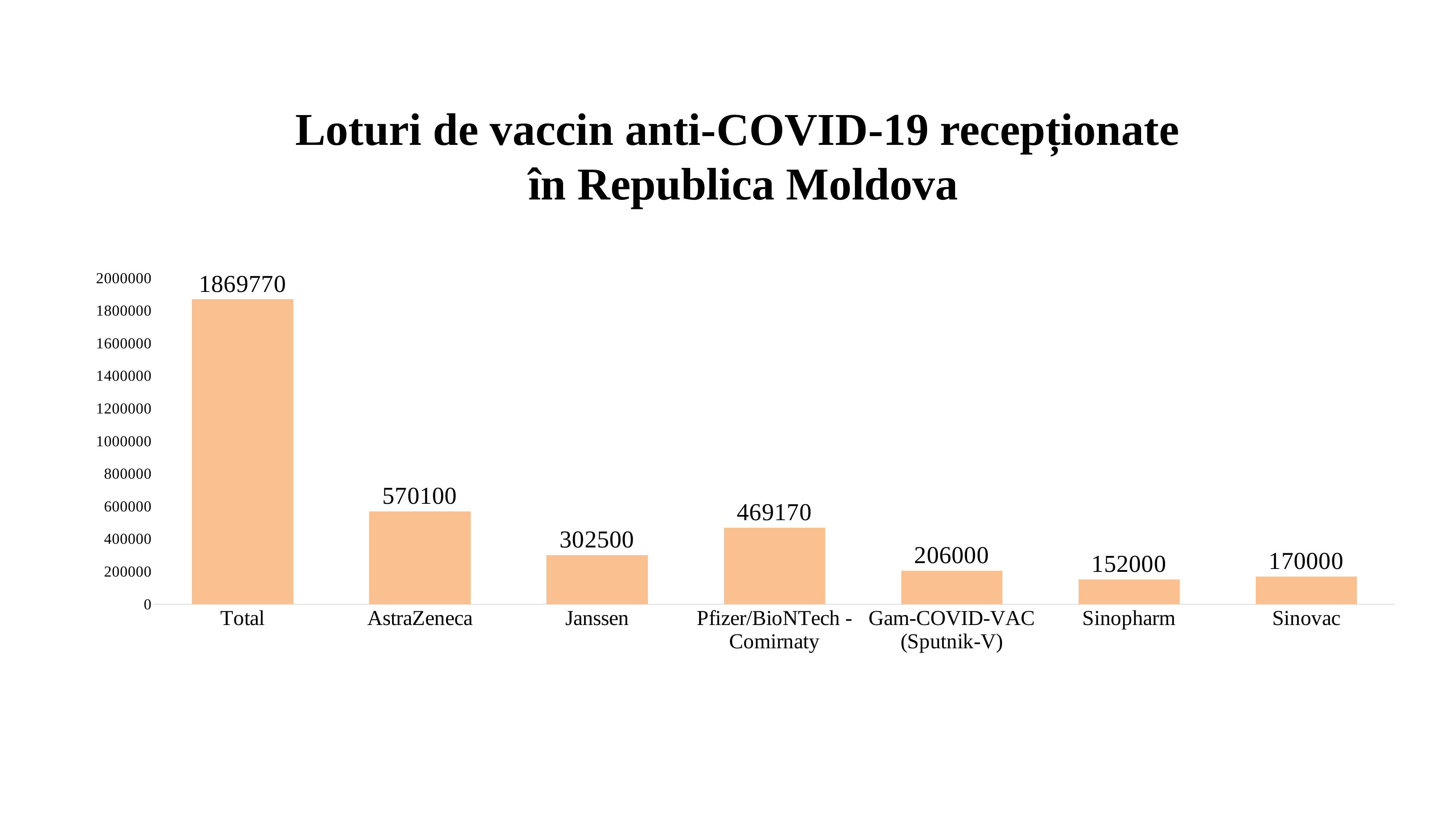
What is the value shown for the Total bar? 1869770 What is the value for AstraZeneca? 570100 What is the value for Pfizer/BioNTech - Comirnaty? 469170 What is the title of the chart? Loturi de vaccin anti-COVID-19 recepționate în Republica Moldova Which is larger, the value for Sinovac or the value for Sinopharm? Sinovac How many bars are shown in the chart? 7 What is the value for Gam-COVID-VAC (Sputnik-V)? 206000 What is the difference between the values for AstraZeneca and Pfizer/BioNTech - Comirnaty? 100930 Excluding the Total bar, which vaccine has the highest value? AstraZeneca What is the value for Janssen? 302500 What kind of chart is shown on the slide? Bar chart Which category has the lowest value? Sinopharm